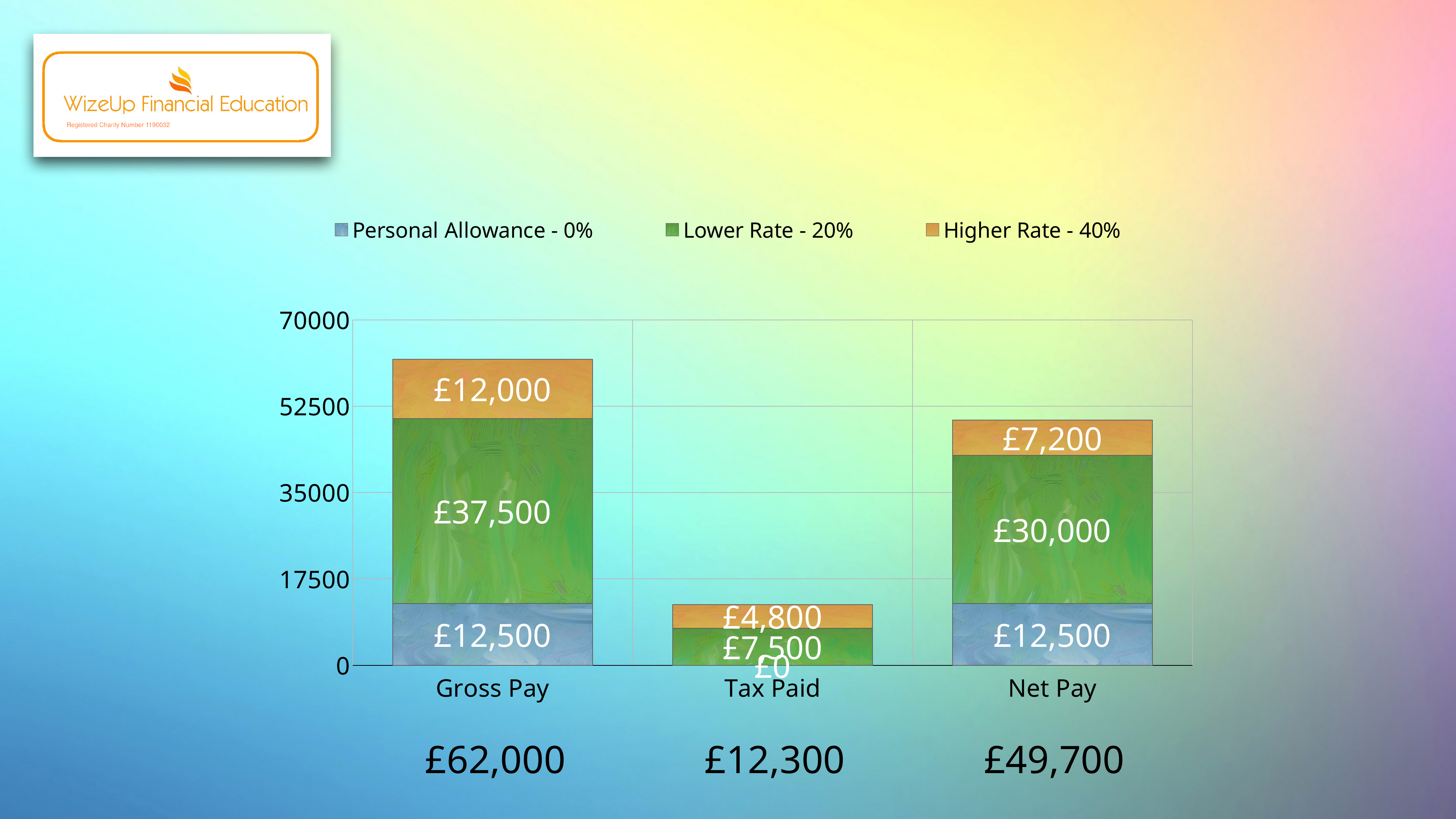
What is the total of the Tax Paid stacked bar? £12,300 Which is larger, the Higher Rate - 40% value for Gross Pay or for Net Pay? Gross Pay How many series does the legend list? 3 What is the Personal Allowance - 0% value for Net Pay? £12,500 What is the Higher Rate - 40% value for Net Pay? £7,200 What kind of chart is shown on the slide? Stacked bar chart What is the Lower Rate - 20% value for Gross Pay? £37,500 How many categories are shown on the x axis? 3 What is the difference between the Lower Rate - 20% values for Gross Pay and Net Pay? £7,500 Which category has the lowest total bar? Tax Paid What is the Higher Rate - 40% value for Tax Paid? £4,800 What is the total of the Gross Pay stacked bar? £62,000